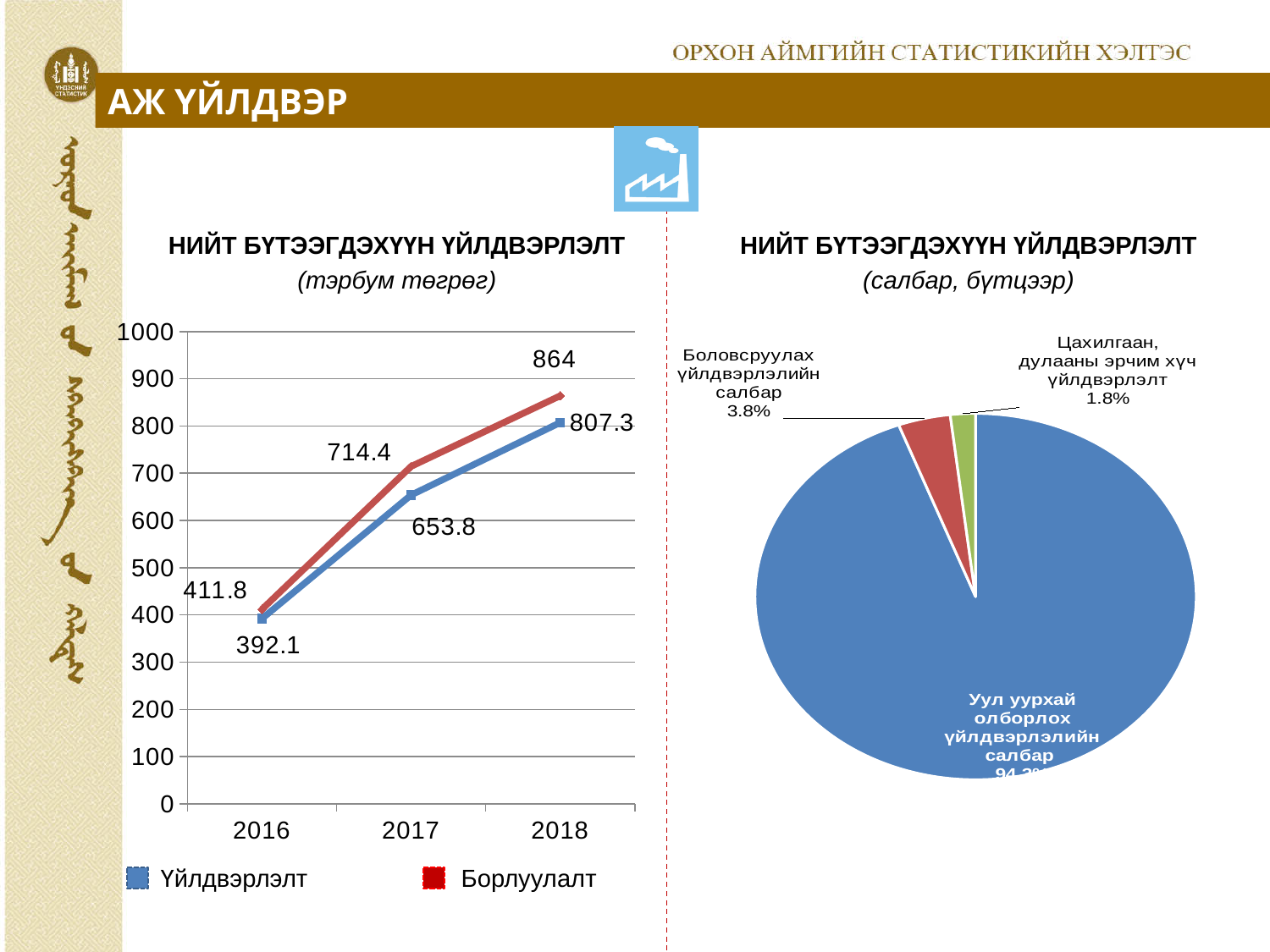
On the left line chart, what is the difference between Борлуулалт and Үйлдвэрлэлт in 2018? 56.7 On the left line chart, in which year is Үйлдвэрлэлт lowest? 2016 What kind of chart is shown on the right side of the slide? pie chart On the right pie chart, what share does Боловсруулах үйлдвэрлэлийн салбар have? 3.8% How many series does the legend of the left line chart list? 2 On the left line chart, what is the value for Үйлдвэрлэлт in 2016? 392.1 On the left line chart, what is the value for Борлуулалт in 2017? 714.4 On the right pie chart, what share does Цахилгаан, дулааны эрчим хүч үйлдвэрлэлт have? 1.8% On the left line chart, do the values for Үйлдвэрлэлт rise or fall from 2016 to 2018? rise On the left line chart, in which year is Борлуулалт highest? 2018 On the left line chart, which is larger in 2017: Үйлдвэрлэлт or Борлуулалт? Борлуулалт On the left line chart, what is the value for Үйлдвэрлэлт in 2018? 807.3